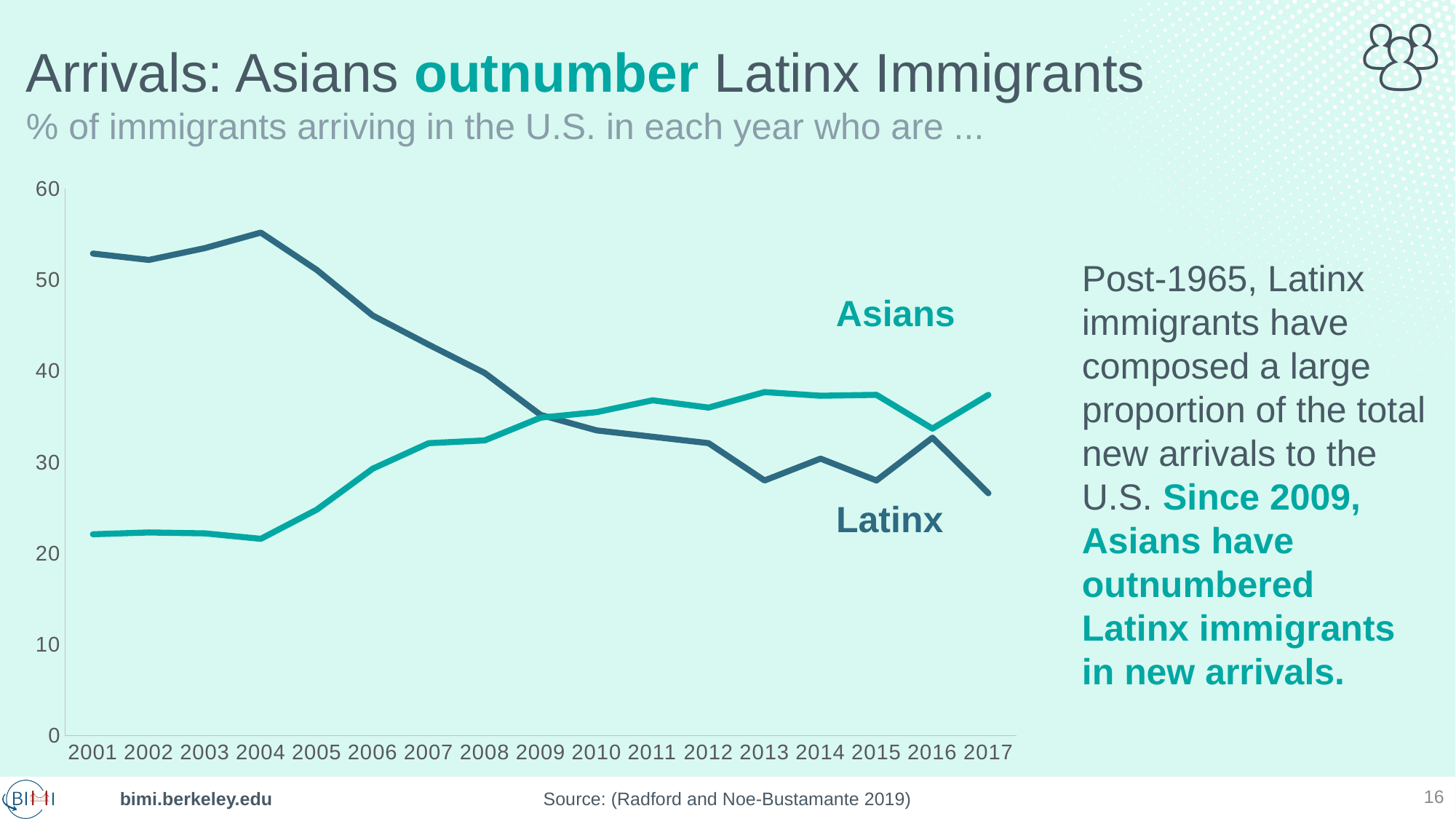
In which year does the Latinx series reach its highest value? 2004 Is the Asians value for 2001 greater or less than 30? less Is the Latinx value for 2017 greater or less than 30? less Is the Asians value for 2011 greater or less than 30? greater How many years are shown on the x axis of the chart? 17 What kind of chart is shown on the slide? line chart In 2001, which series has the higher value, Asians or Latinx? Latinx How many series are plotted on the chart? 2 Does the Latinx series rise or fall from 2004 to 2009? fall In 2017, which series has the higher value, Asians or Latinx? Asians What is the title of the slide's chart? Arrivals: Asians outnumber Latinx Immigrants